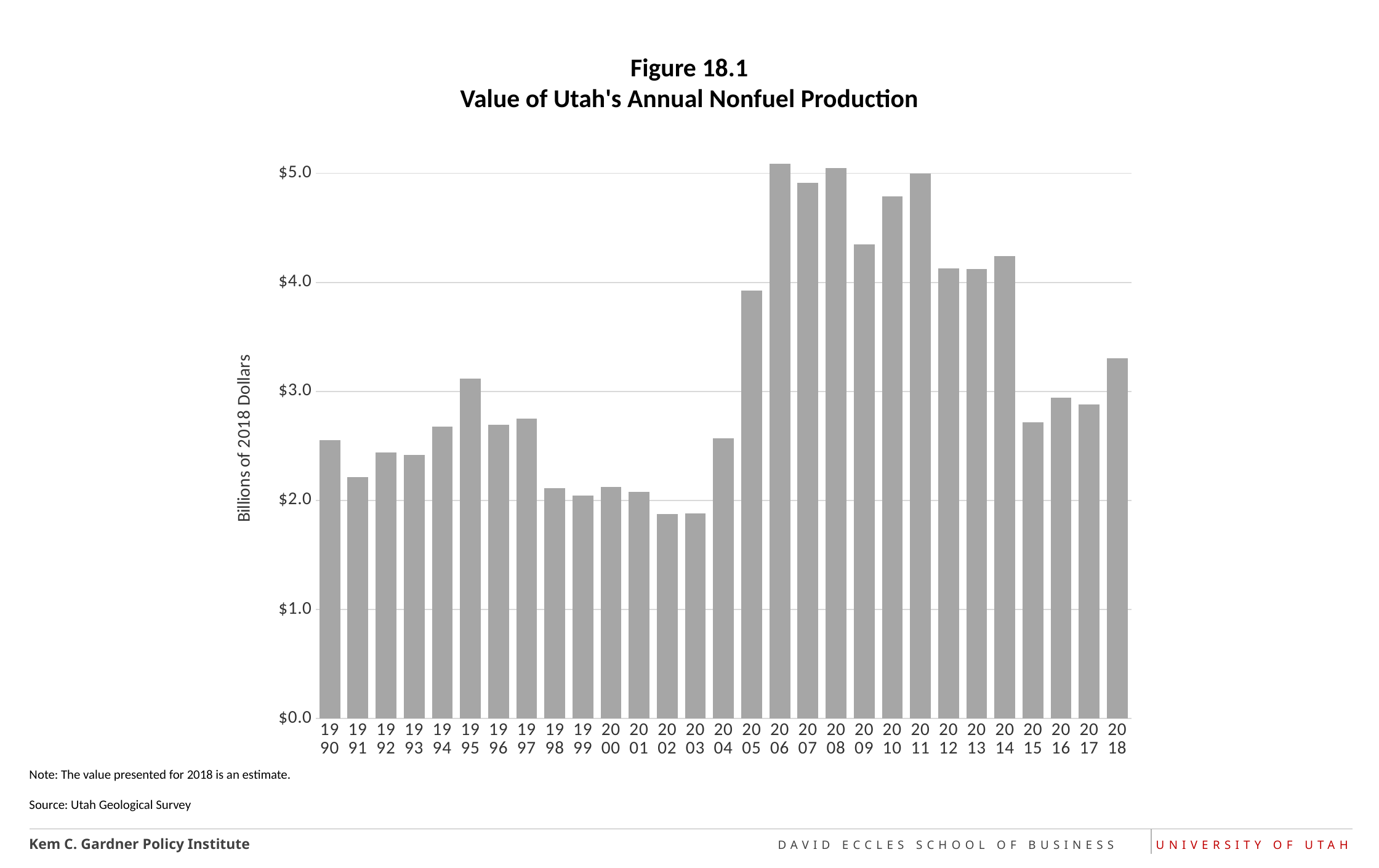
Is the value for 2018 greater or less than $3.0 billion? greater How many years are plotted in the chart? 29 Do the values rise or fall from 2011 to 2015? fall Is the value for 2002 greater or less than $2.0 billion? less Is the value for 2006 greater or less than $5.0 billion? greater What kind of chart is shown in Figure 18.1? Bar chart What is the label on the vertical axis of the chart? Billions of 2018 Dollars Which year has the larger value, 2018 or 2017? 2018 Which year has the larger value, 2006 or 2002? 2006